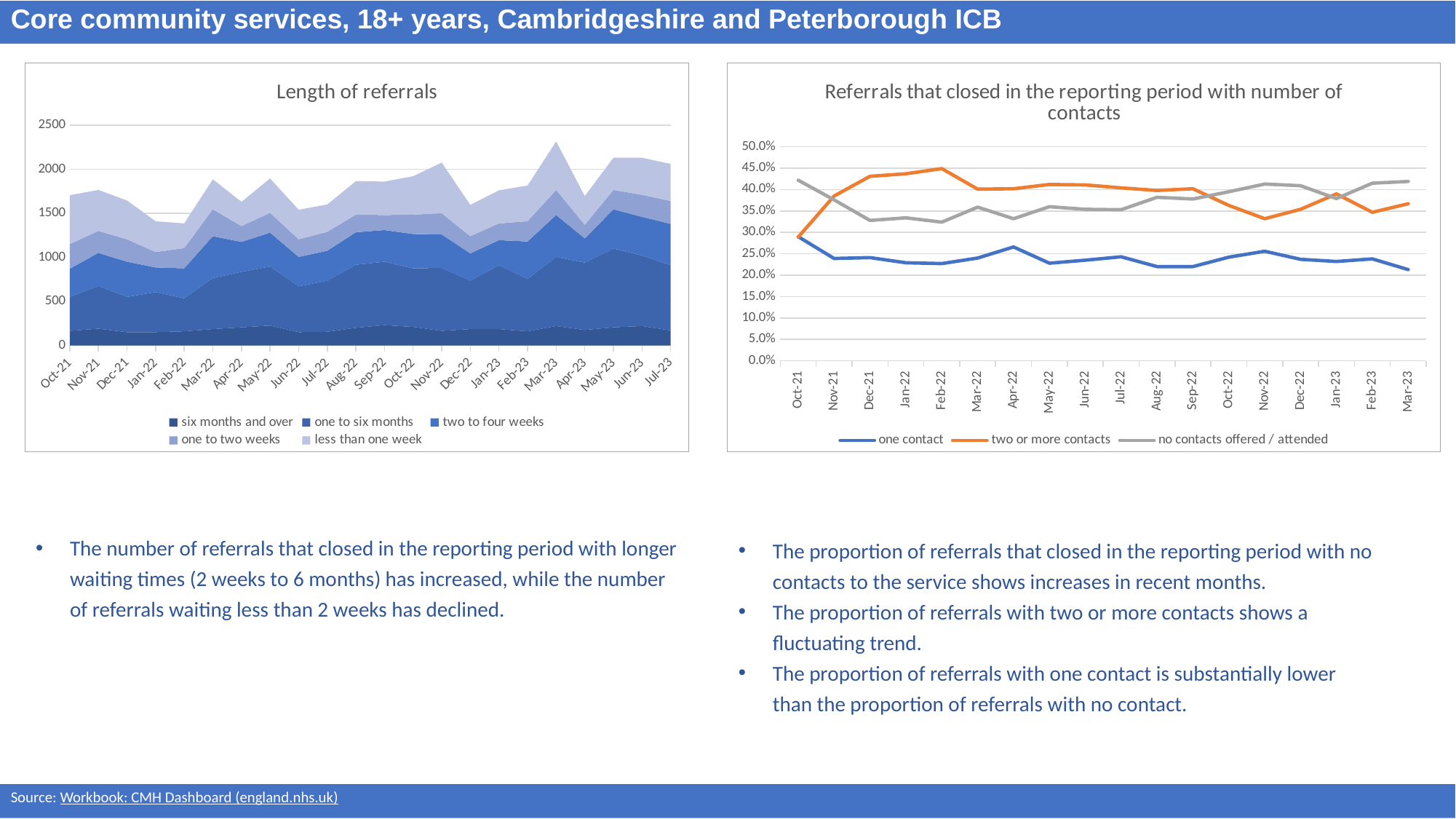
In the right-hand chart, is the value for 'one contact' in Oct-21 greater or less than 25.0%? greater What kind of chart is the 'Length of referrals' chart on the left? stacked area chart In the right-hand chart, does the 'one contact' line rise or fall from Nov-22 to Mar-23? fall How many months are shown on the x axis of the 'Referrals that closed in the reporting period with number of contacts' chart? 18 In the 'Length of referrals' chart, is the total stacked value for Jan-22 greater or less than 1500? less How many months are shown on the x axis of the 'Length of referrals' chart? 22 How many series does the legend of the 'Length of referrals' chart list? 5 In the 'Length of referrals' chart, is the total stacked value for Mar-23 greater or less than 2000? greater What kind of chart is the 'Referrals that closed in the reporting period with number of contacts' chart on the right? line chart How many series does the legend of the 'Referrals that closed in the reporting period with number of contacts' chart list? 3 In the right-hand chart, which is larger in Mar-23: 'one contact' or 'no contacts offered / attended'? no contacts offered / attended